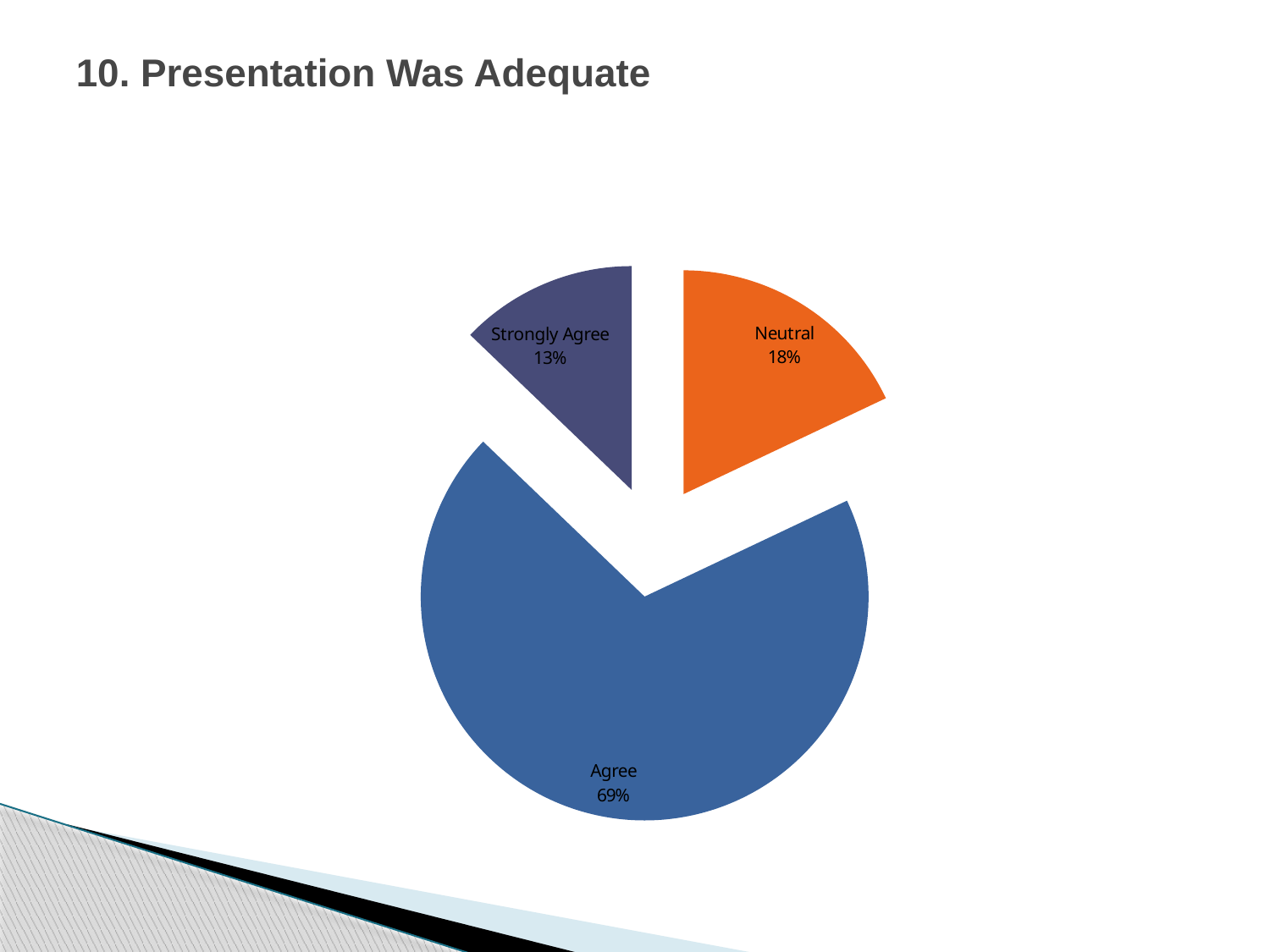
What percentage of respondents chose Strongly Agree? 13% What is the combined share of Agree and Strongly Agree? 82% What kind of chart is shown on the slide? pie chart Which is larger, the Neutral share or the Strongly Agree share? Neutral What is the difference in percentage points between Neutral and Strongly Agree? 5 Which response has the smallest share of the pie? Strongly Agree What is the title of the slide containing the pie chart? 10. Presentation Was Adequate Which response has the largest share of the pie? Agree How many slices does the pie chart have? 3 What percentage of respondents chose Agree? 69% What is the difference in percentage points between Agree and Neutral? 51 What percentage of respondents chose Neutral? 18%